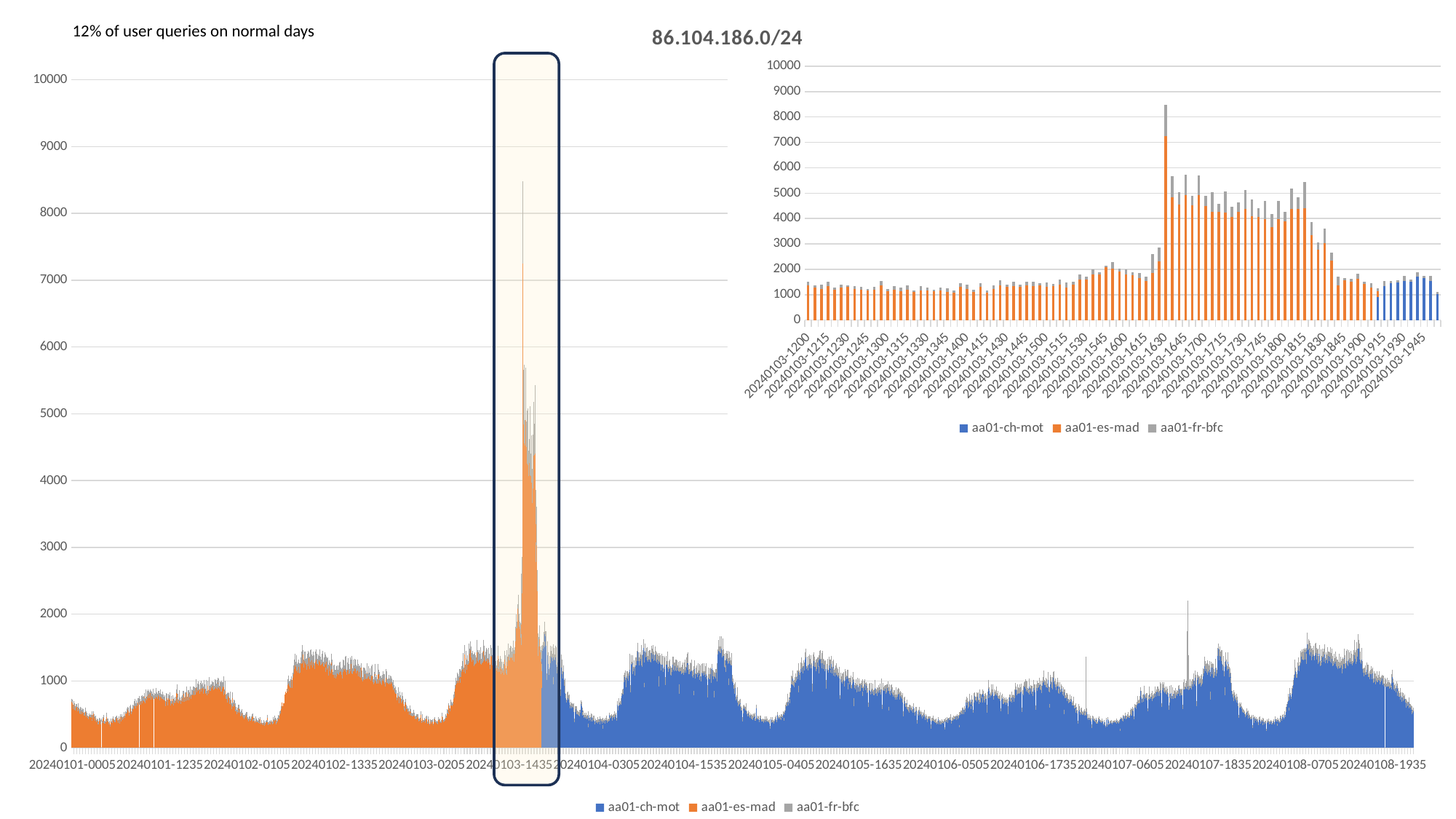
In the large chart on the left, what is the last label on the x axis? 20240108-1935 In the chart titled 86.104.186.0/24, is the tallest bar (around 20240103-1630) greater or less than 7000? greater What kind of chart is the chart titled 86.104.186.0/24? bar chart In the chart titled 86.104.186.0/24, is the value at 20240103-1200 greater or less than 2000? less How many series does the legend of the large chart on the left list? 3 In the large chart on the left, is the peak inside the highlighted box (around 20240103-1435) greater or less than 7000? greater In the chart titled 86.104.186.0/24, which series is drawn in blue? aa01-ch-mot What kind of chart is the large chart on the left of the slide? bar chart In the chart titled 86.104.186.0/24, do the values rise or fall between 20240103-1830 and 20240103-1900? fall How many series does the legend of the chart titled 86.104.186.0/24 list? 3 What is the highest value shown on the y axis of the chart titled 86.104.186.0/24? 10000